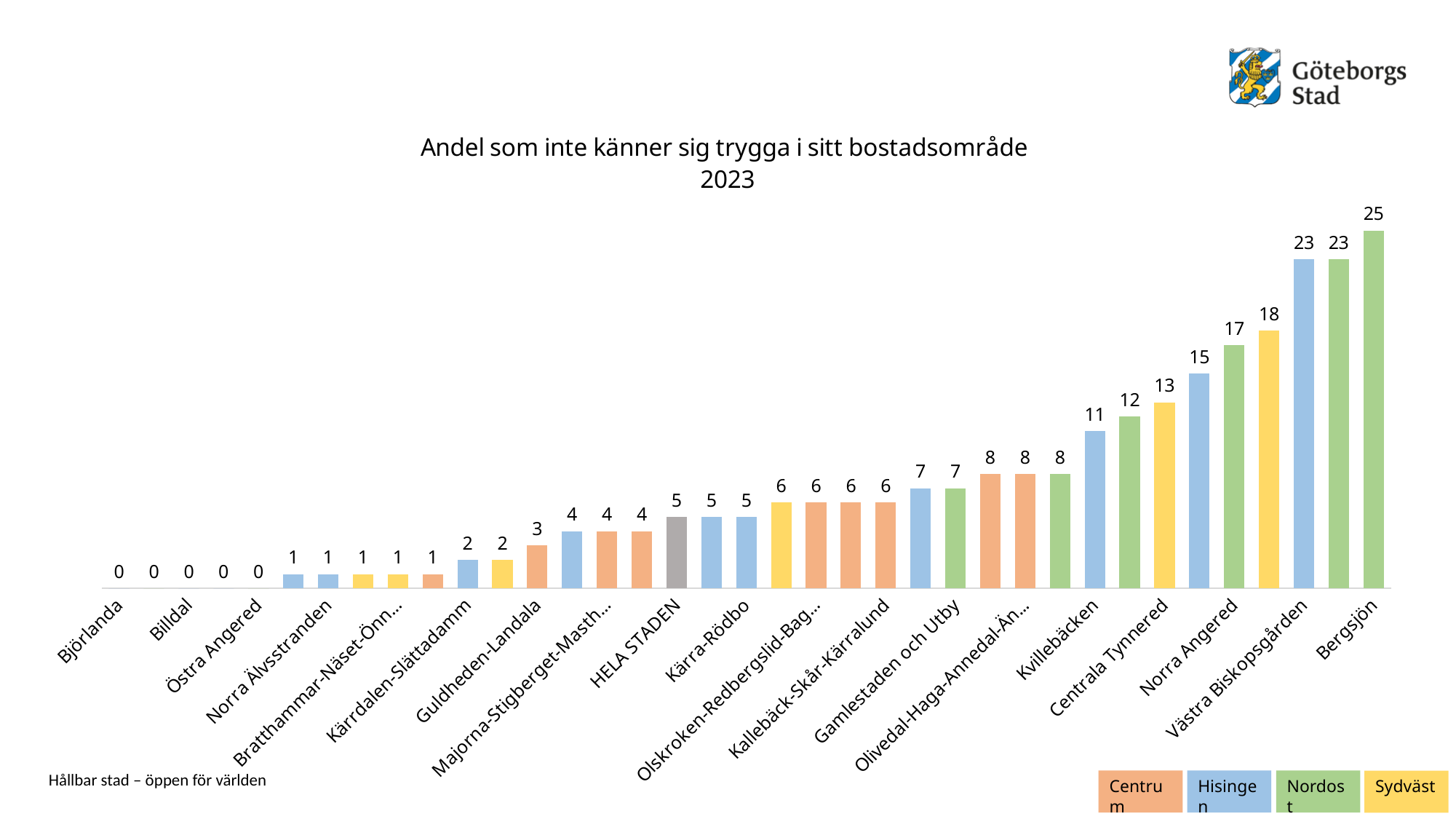
What is the value for Kvillebäcken? 11 What kind of chart is shown on the slide? Bar chart How many bars are plotted in the chart? 37 Which is larger, the value for Gamlestaden och Utby or the value for Kärra-Rödbo? Gamlestaden och Utby What is the value for Bergsjön? 25 How many entries does the legend list? 4 What is the difference between the values for Bergsjön and HELA STADEN? 20 Which category has the highest value? Bergsjön Do the values rise or fall from left to right along the x axis? Rise What is the difference between the values for Västra Biskopsgården and Centrala Tynnered? 10 What is the value for HELA STADEN? 5 What is the value for Norra Angered? 17